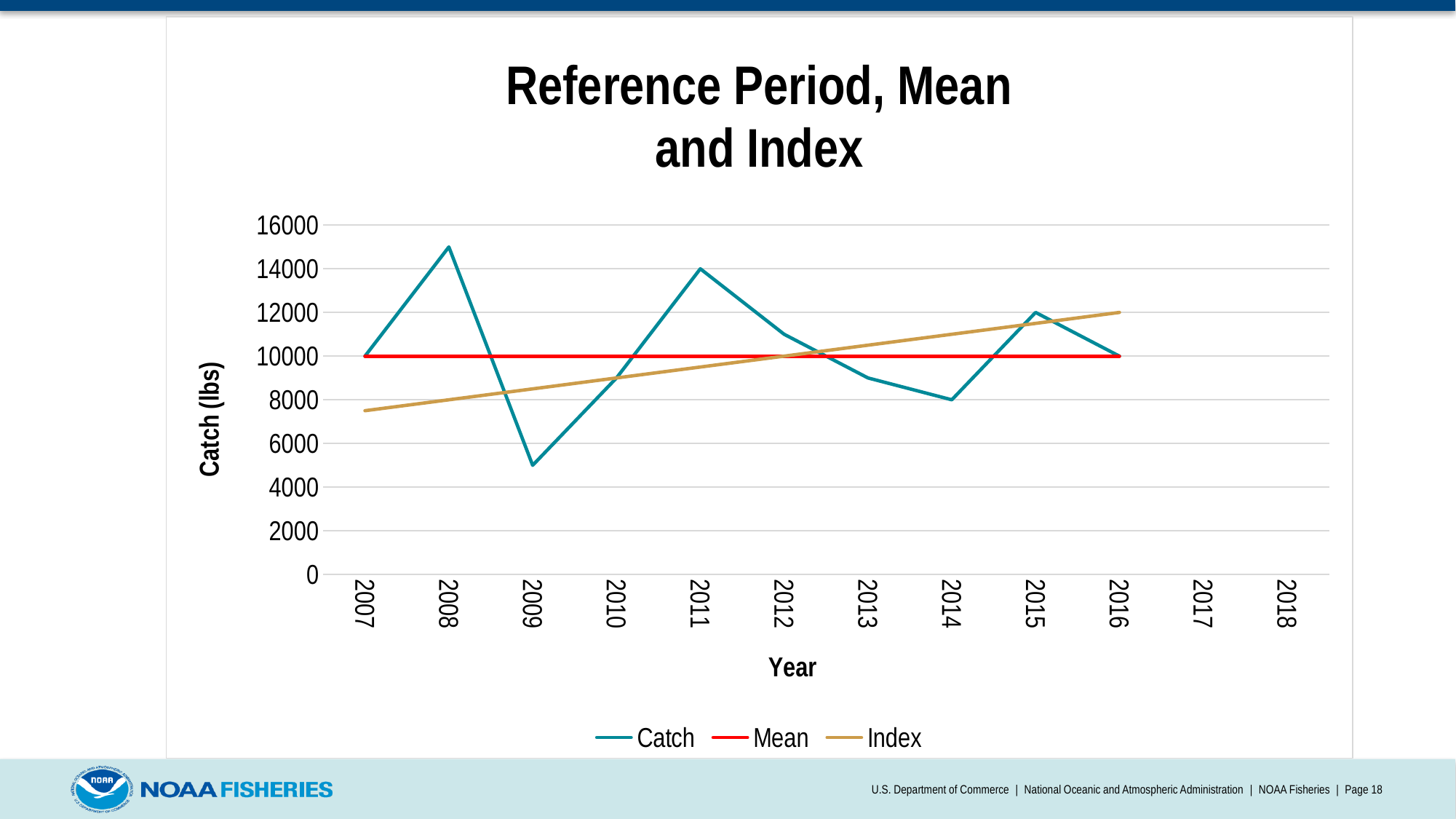
How many series does the legend list? 3 What is the title of the vertical axis? Catch (lbs) What is the Catch value for 2011? 14000 What is the value of the Mean series across the reference period? 10000 Does the Index series rise or fall from 2007 to 2016? Rises In which year is the Catch lowest? 2009 In which year is the Catch highest? 2008 What is the Catch value for 2014? 8000 What is the difference between the Catch values for 2011 and 2014? 6000 Is the Index value for 2007 greater or less than 8000? less What kind of chart is shown on the slide? Line chart Is the Catch value for 2009 greater or less than 6000? less